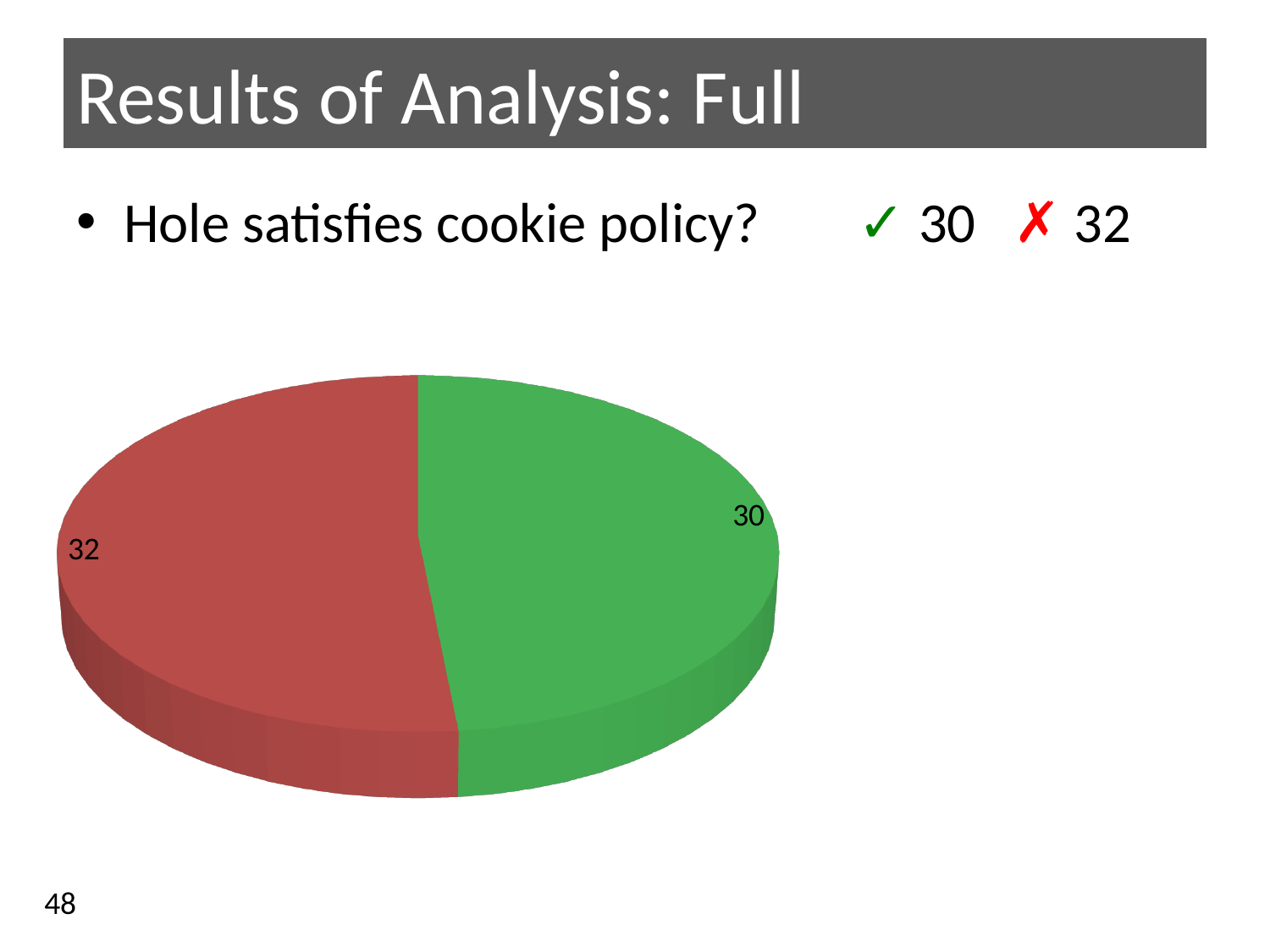
What is the difference between the values of the red slice and the green slice? 2 Which slice of the pie chart has the larger value, the red or the green one? red What value is labelled on the green slice of the pie chart? 30 Which slice of the pie chart has the smaller value, the red or the green one? green What is the title of the slide containing the pie chart? Results of Analysis: Full Is the value of the red slice larger or smaller than the value of the green slice? larger What colour is the slice representing the value 32? red What value is labelled on the red slice of the pie chart? 32 How many slices does the pie chart have? 2 What is the total of the two values shown on the pie chart? 62 What kind of chart is shown on the slide? pie chart According to the slide, how many holes satisfy the cookie policy? 30